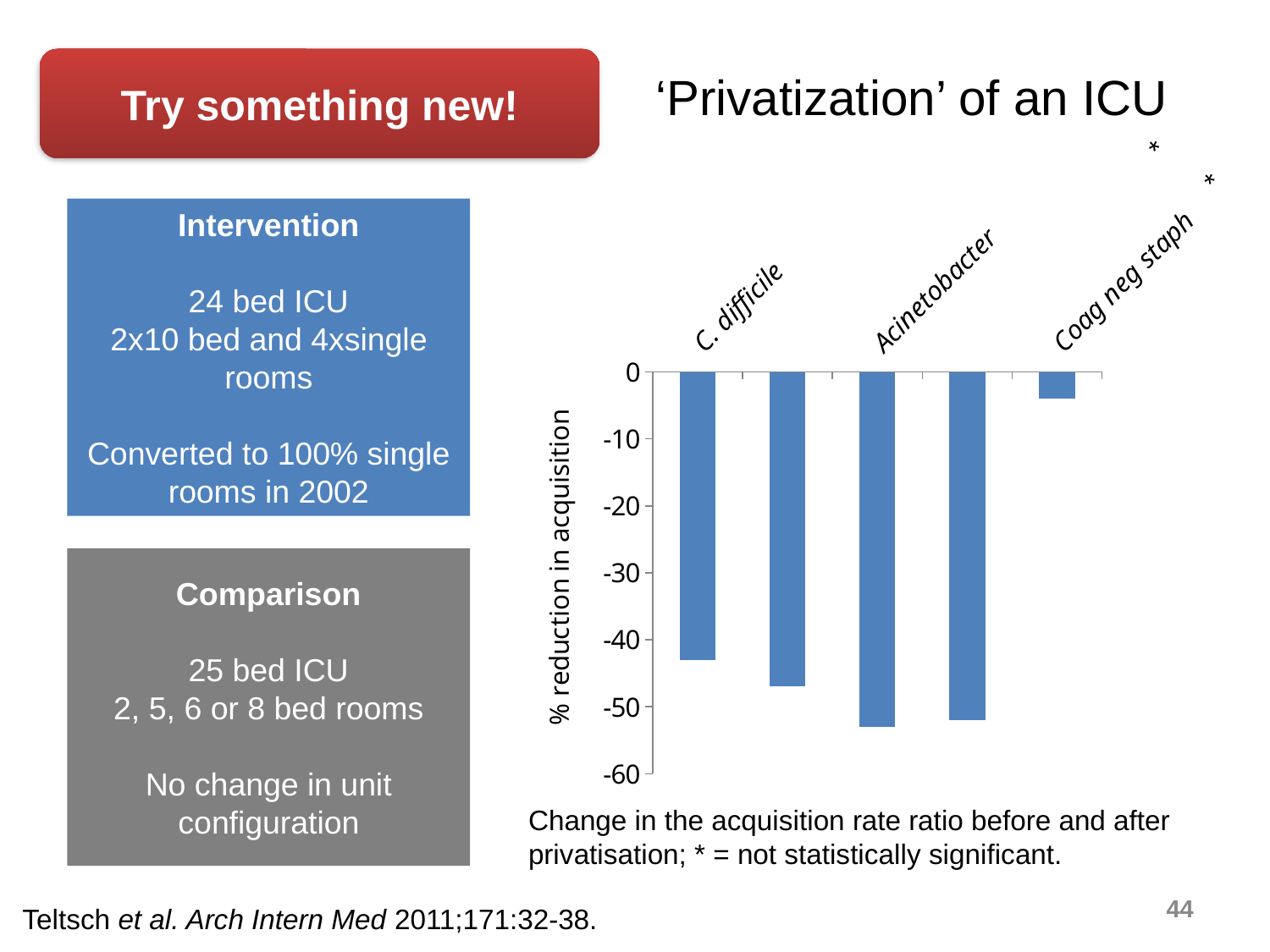
Is the value for Coag neg staph greater or less than -10? greater Which shows a larger reduction in acquisition, Acinetobacter or Coag neg staph? Acinetobacter Which shows a larger reduction in acquisition, C. difficile or Acinetobacter? Acinetobacter What is the title shown above the chart? 'Privatization' of an ICU How many bars are plotted in the chart? 5 What is the label of the chart's vertical axis? % reduction in acquisition Is the value for C. difficile greater or less than -40? less What is the lowest tick value shown on the vertical axis? -60 Which category shows the smallest reduction in acquisition (shortest bar)? Coag neg staph Is the value for Acinetobacter greater or less than -50? less What type of chart is shown on the slide? bar chart